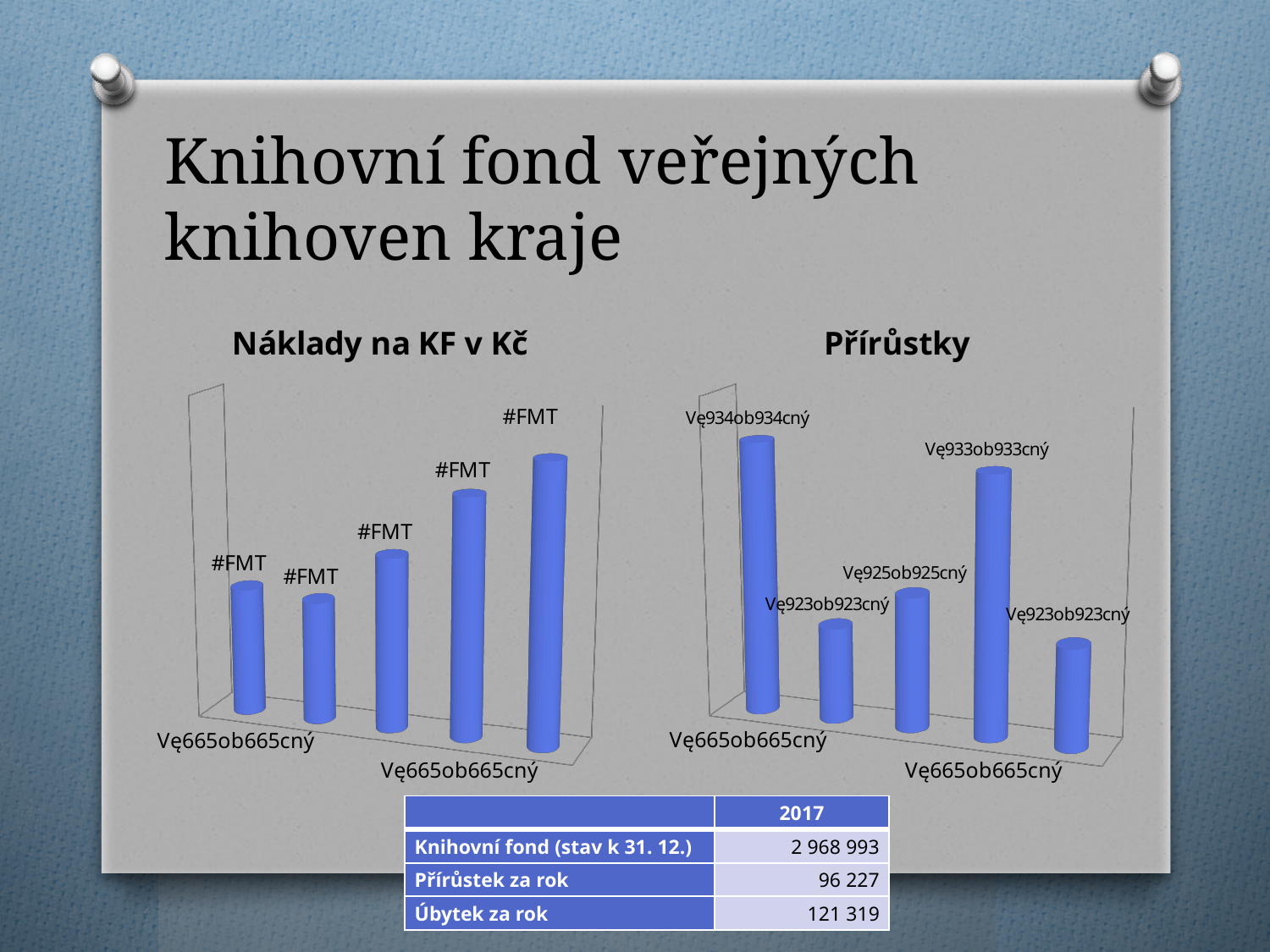
In the left chart "Náklady na KF v Kč", which is taller, the third bar or the fourth bar? the fourth bar What is the title of the chart on the left side of the slide? Náklady na KF v Kč In the left chart "Náklady na KF v Kč", which bar is the tallest? the fifth (rightmost) bar In the right chart "Přírůstky", which is taller, the first bar or the second bar? the first bar In the right chart "Přírůstky", how many bars are plotted? 5 In the left chart "Náklady na KF v Kč", how many bars are plotted? 5 In the left chart "Náklady na KF v Kč", do the bars generally rise or fall from left to right? rise What is the title of the chart on the right side of the slide? Přírůstky In the right chart "Přírůstky", which is taller, the third bar or the fourth bar? the fourth bar What kind of chart is the right chart titled "Přírůstky"? bar chart What kind of chart is the left chart titled "Náklady na KF v Kč"? bar chart